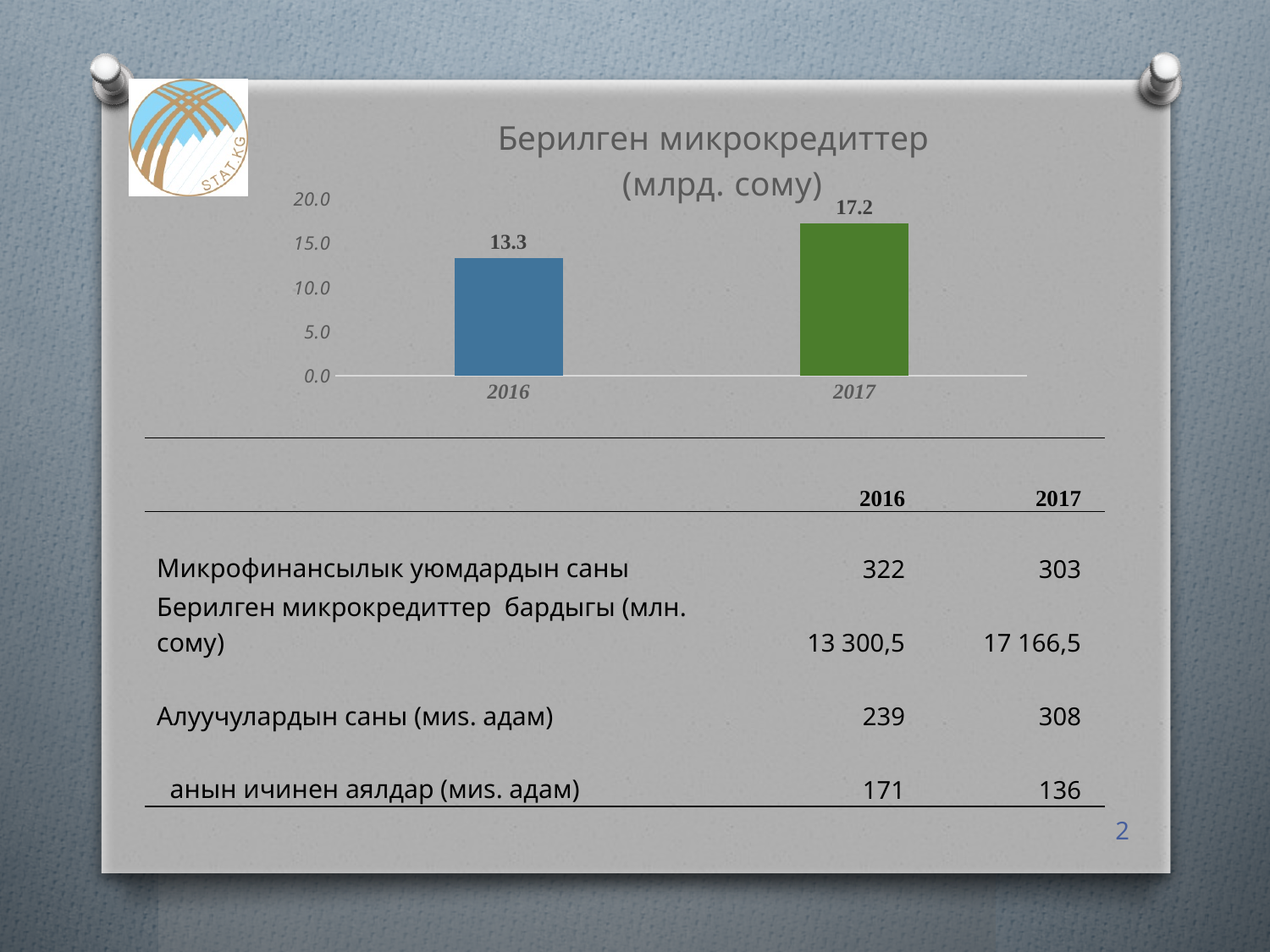
What kind of chart is shown on the slide? bar chart What is the difference between the 2017 and 2016 values in the chart? 3.9 How many categories are shown on the x axis of the chart? 2 What is the value for 2016 in the chart? 13.3 What is the value for 2017 in the chart? 17.2 Do the values rise or fall from 2016 to 2017 in the chart? rise Which is larger in the chart, the value for 2016 or the value for 2017? 2017 Which year has the highest value in the chart? 2017 What is the title of the chart? Берилген микрокредиттер (млрд. сому) Which year has the lowest value in the chart? 2016 Is the value for 2017 greater or less than 15.0? greater Is the value for 2016 greater or less than 15.0? less